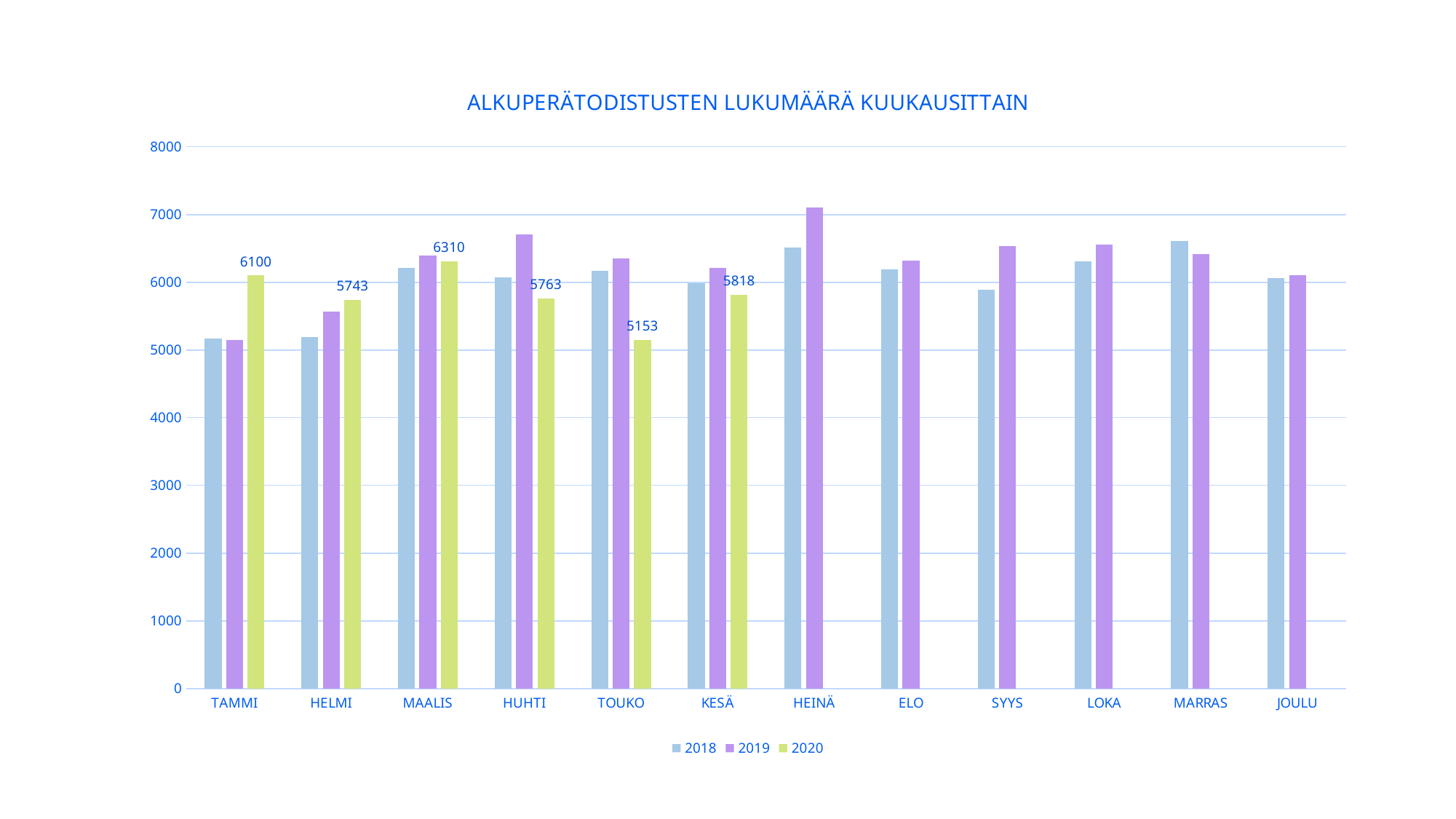
What kind of chart is shown on the slide? bar chart Which is larger, the 2020 value for HELMI or the 2020 value for KESÄ? KESÄ Is the value for 2019 in HEINÄ greater or less than 7000? greater Which month has the highest 2020 value? MAALIS How many months are shown on the x axis? 12 What is the value for 2020 in TOUKO? 5153 What is the value for 2020 in MAALIS? 6310 What is the difference between the 2020 values for MAALIS and TOUKO? 1157 What is the value for 2020 in TAMMI? 6100 How many series does the legend list? 3 Which month has the lowest 2020 value? TOUKO Is the value for 2019 in TAMMI greater or less than 6000? less